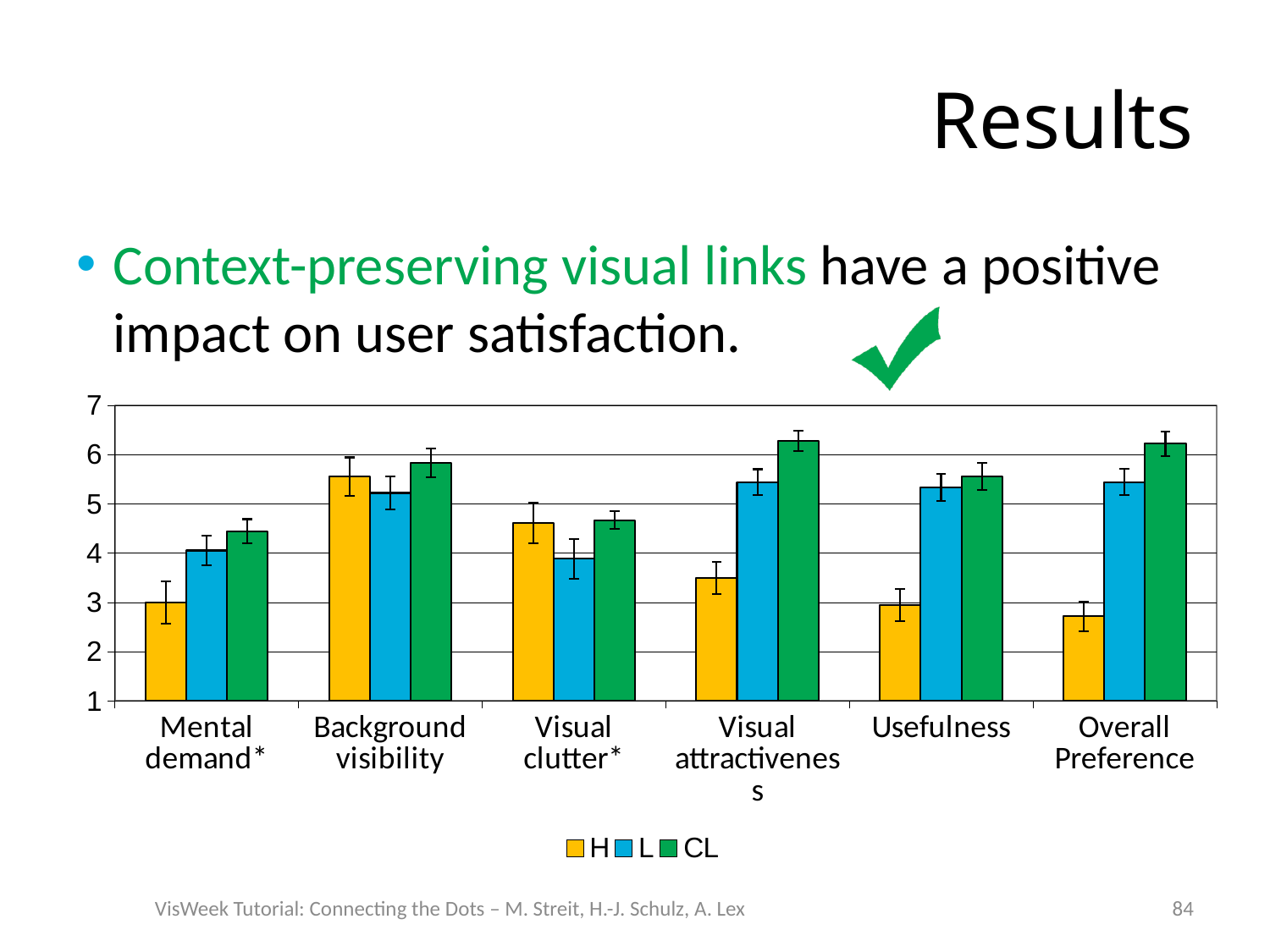
Is the value of the H bar for Mental demand* greater or less than 4? less Is the value of the L bar for Usefulness greater or less than 5? greater Is the value of the CL bar for Visual attractiveness greater or less than 6? greater What are the series names listed in the chart's legend? H, L, CL For Visual clutter*, which is larger: the H bar or the L bar? H What kind of chart is shown on the slide? bar chart How many categories are shown along the x axis of the chart? 6 Which series has the lowest bar for Visual attractiveness? H Which is larger: the H bar for Background visibility or the H bar for Mental demand*? Background visibility How many series does the chart's legend list? 3 Which series has the highest bar for Overall Preference? CL